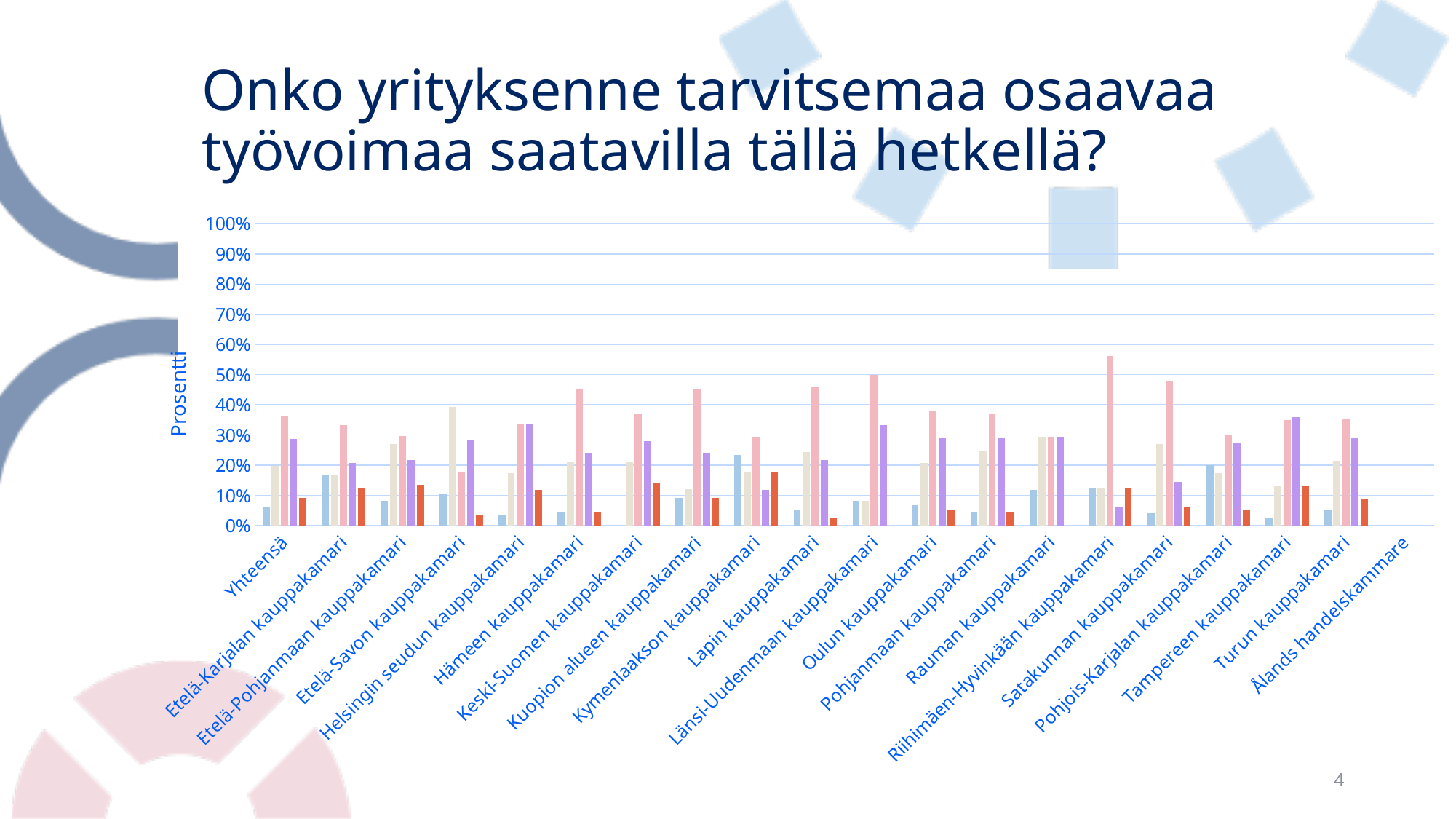
Is the pink bar for Riihimäen-Hyvinkään kauppakamari greater or less than 50%? greater What is the highest value shown on the vertical axis of the chart? 100% How many categories are listed along the x axis of the chart? 20 Which has the taller pink bar: Hämeen kauppakamari or Etelä-Karjalan kauppakamari? Hämeen kauppakamari What kind of chart is shown on the slide? bar chart Is the pink bar for Yhteensä greater or less than 30%? greater Is the purple bar for Riihimäen-Hyvinkään kauppakamari greater or less than 10%? less Which category has the tallest pink bar in the chart? Riihimäen-Hyvinkään kauppakamari What is the label of the vertical axis of the chart? Prosentti